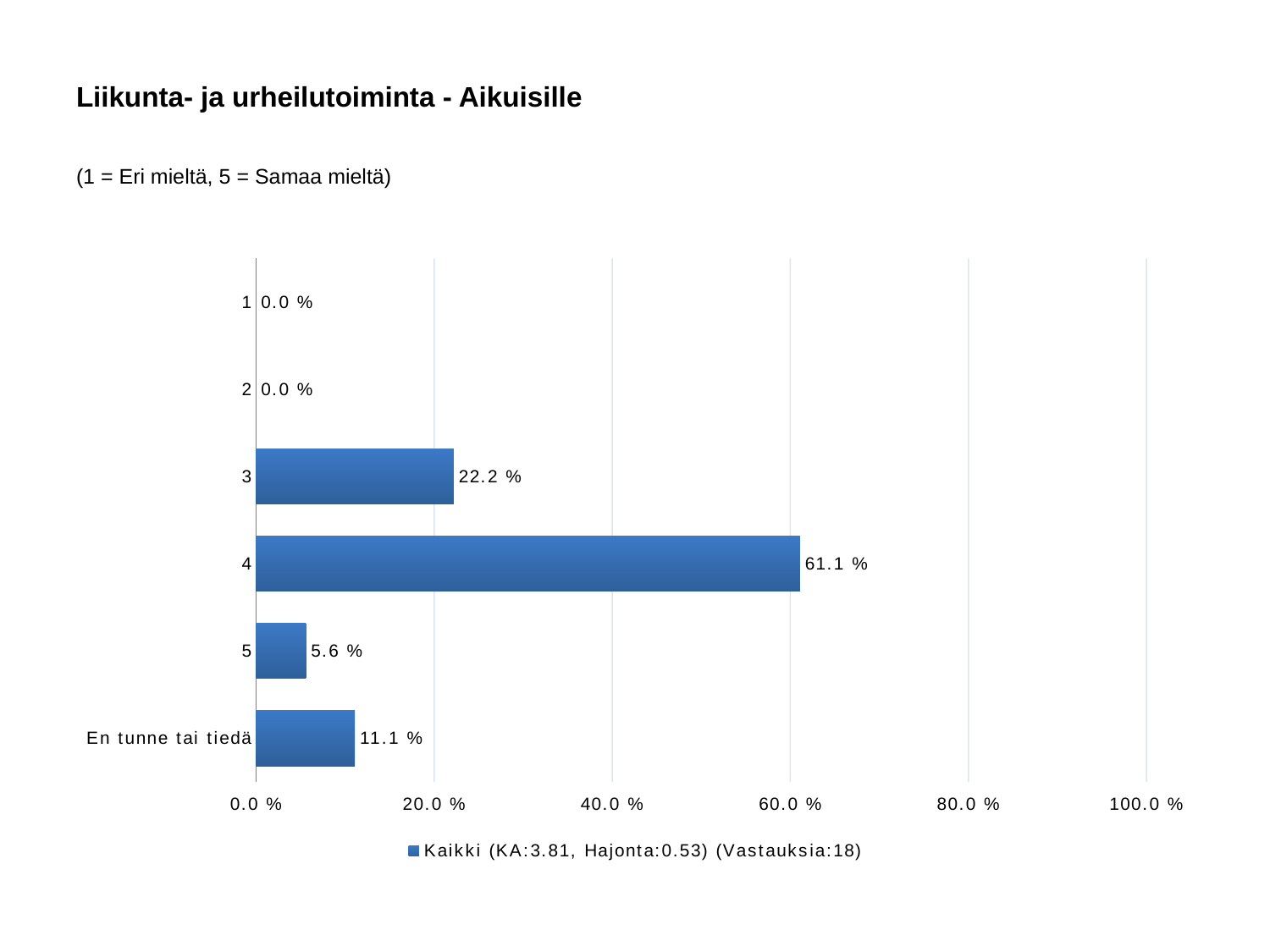
Which category has the highest value? 4 What is the difference between the values for category 4 and category 3? 38.9 % How many categories are shown on the chart? 6 Which is larger, the value for category 5 or for 'En tunne tai tiedä'? En tunne tai tiedä What is the value for 'En tunne tai tiedä'? 11.1 % What is the value for category 3? 22.2 % What is the title of the chart? Liikunta- ja urheilutoiminta - Aikuisille Is the value for category 4 greater or less than 60.0 %? greater How many series does the legend list? 1 What is the value for category 5? 5.6 % What is the value for category 4? 61.1 % What kind of chart is shown on the slide? bar chart